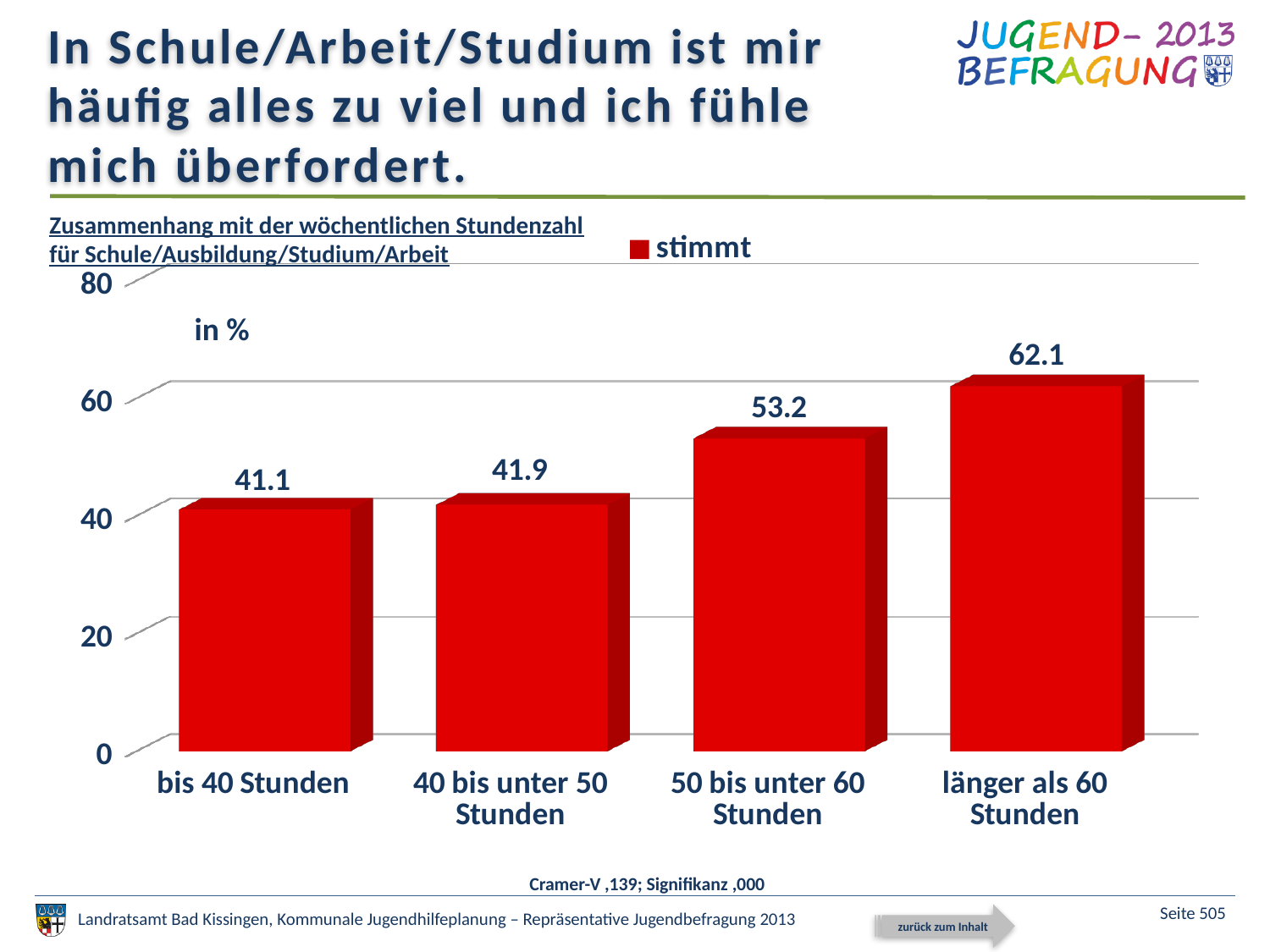
Which category has the highest value? länger als 60 Stunden Which category has the lowest value? bis 40 Stunden What is the value for "50 bis unter 60 Stunden"? 53.2 What is the difference between the values for "länger als 60 Stunden" and "bis 40 Stunden"? 21.0 What is the difference between the values for "50 bis unter 60 Stunden" and "40 bis unter 50 Stunden"? 11.3 Which is larger, the value for "50 bis unter 60 Stunden" or for "bis 40 Stunden"? 50 bis unter 60 Stunden What is the value for "länger als 60 Stunden"? 62.1 What is the value for "bis 40 Stunden"? 41.1 What is the value for "40 bis unter 50 Stunden"? 41.9 How many categories are shown on the x axis? 4 What kind of chart is shown on the slide? bar chart Do the values rise or fall from left to right along the x axis? rise